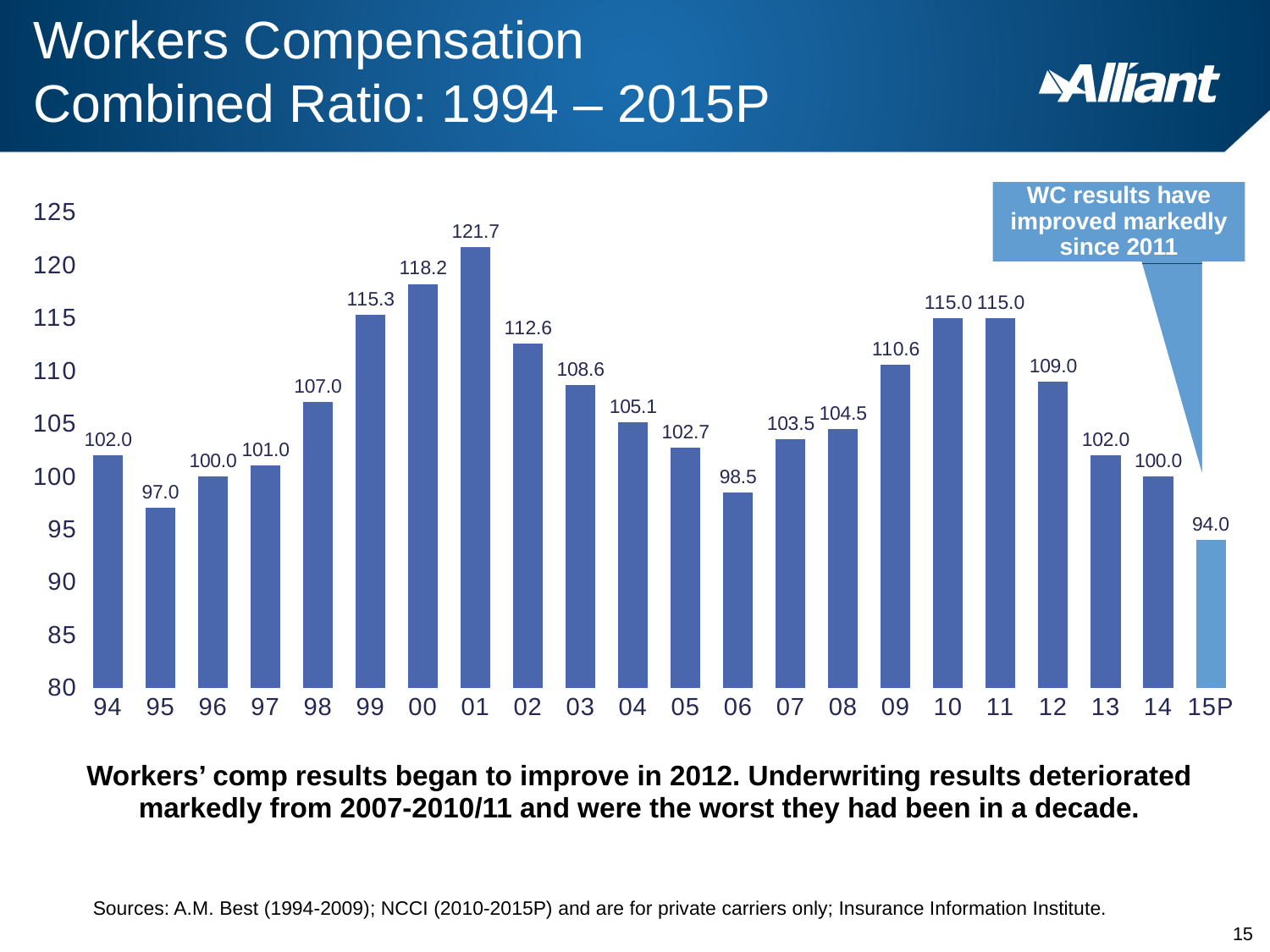
How many years are shown on the x axis? 22 What is the difference between the combined ratio in 2011 and in 2012? 6.0 Which is larger, the combined ratio for 2000 or for 2009? 2000 What is the difference between the combined ratio in 2001 and in 2015P? 27.7 What is the workers compensation combined ratio for 2001? 121.7 Do the combined ratio values rise or fall from 2011 to 2015P? Fall Which year has the highest combined ratio? 01 What is the combined ratio shown for 15P? 94.0 Which year has the lowest combined ratio? 15P What kind of chart is shown on the slide? Bar chart What is the combined ratio for 2006? 98.5 Is the combined ratio for 1999 greater or less than 110? greater